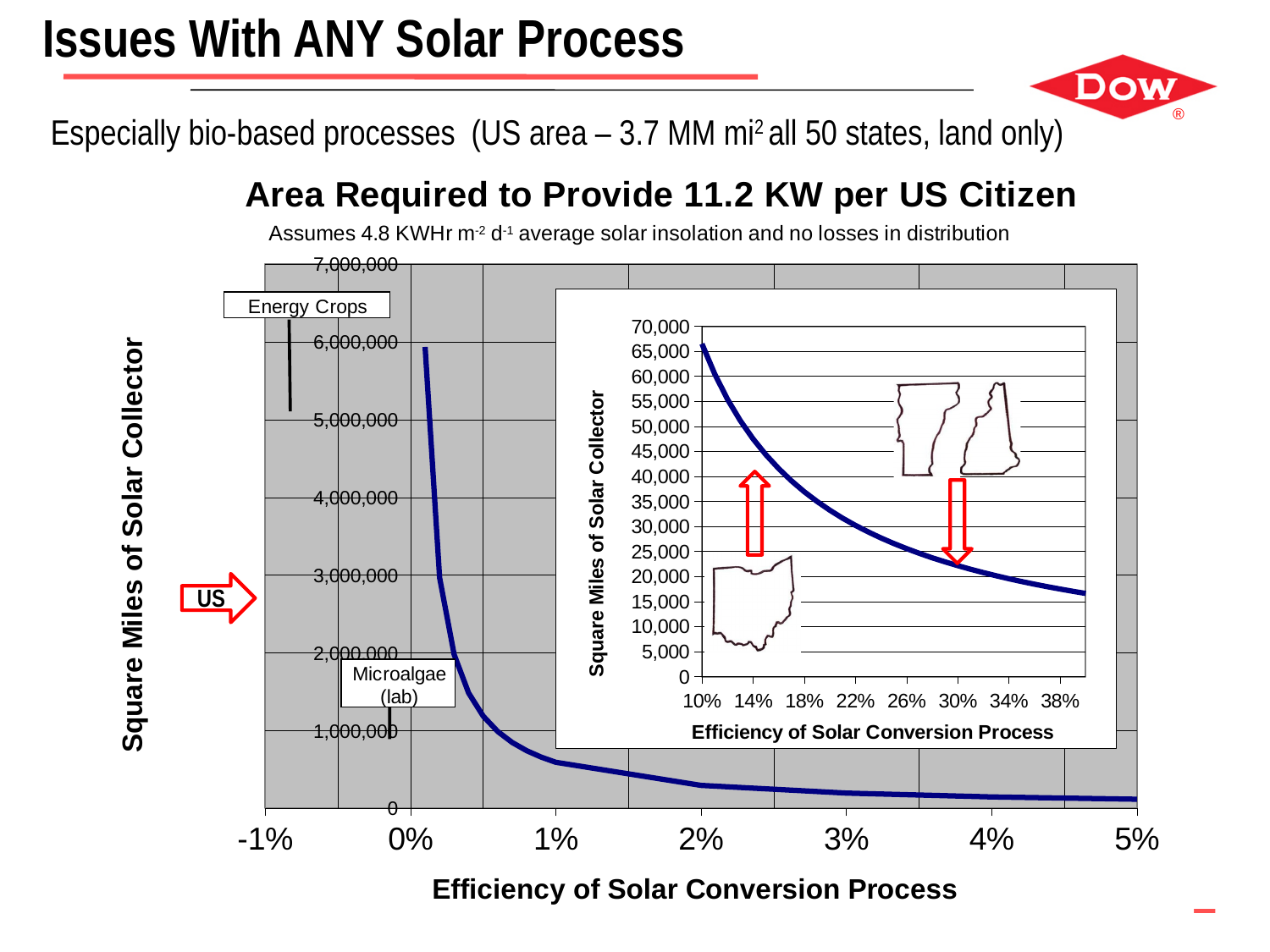
In the main chart, which efficiency requires more square miles of solar collector, 1% or 3%? 1% What is the y-axis label of the main chart? Square Miles of Solar Collector In the main chart, do the values rise or fall as the efficiency of solar conversion process increases along the x axis? fall In the inset chart, is the value for 38% efficiency greater or less than 20,000 square miles? less In the inset chart, do the values rise or fall as efficiency increases from 10% to 38%? fall In the inset chart, is the value for 14% efficiency greater or less than 40,000 square miles? greater In the main chart, is the value for 1% efficiency greater or less than 1,000,000 square miles? less What is the title of the main chart? Area Required to Provide 11.2 KW per US Citizen In the inset chart, which efficiency requires more square miles of solar collector, 10% or 38%? 10% What kind of chart is the main chart titled 'Area Required to Provide 11.2 KW per US Citizen'? line chart